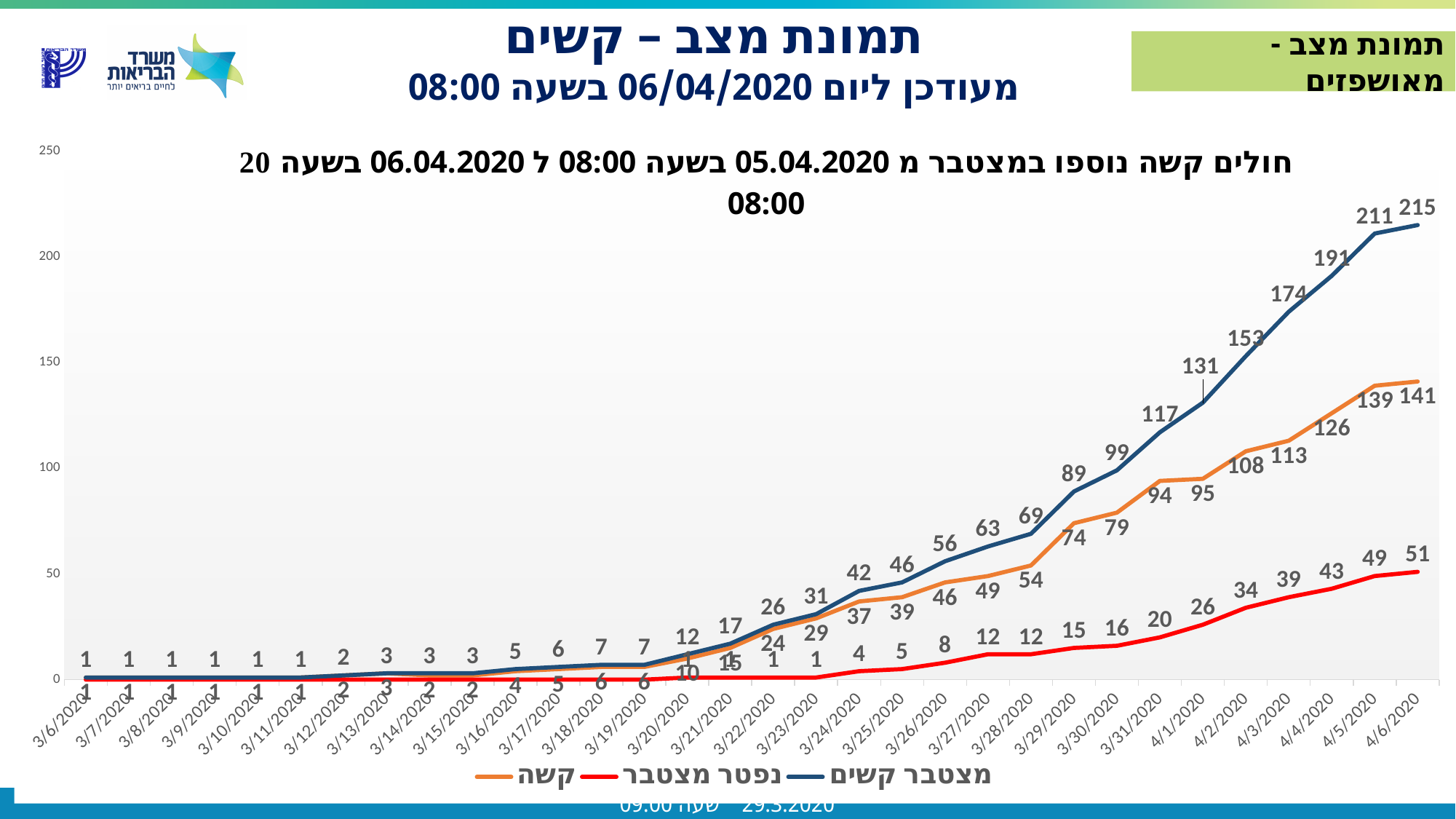
What is the value of מצטבר קשים on 4/1/2020? 131 By how much did מצטבר קשים increase from 4/5/2020 to 4/6/2020? 4 On which date is מצטבר קשים highest? 4/6/2020 What is the value of מצטבר קשים on 4/6/2020? 215 How many series does the legend list? 3 What is the value of קשה on 4/5/2020? 139 Does the מצטבר קשים series rise or fall over the dates shown? rise What kind of chart is shown on the slide? line chart On 4/6/2020, which is larger: מצטבר קשים or קשה? מצטבר קשים By how much did נפטר מצטבר increase from 4/5/2020 to 4/6/2020? 2 What colour is the נפטר מצטבר line? red What is the value of נפטר מצטבר on 4/6/2020? 51